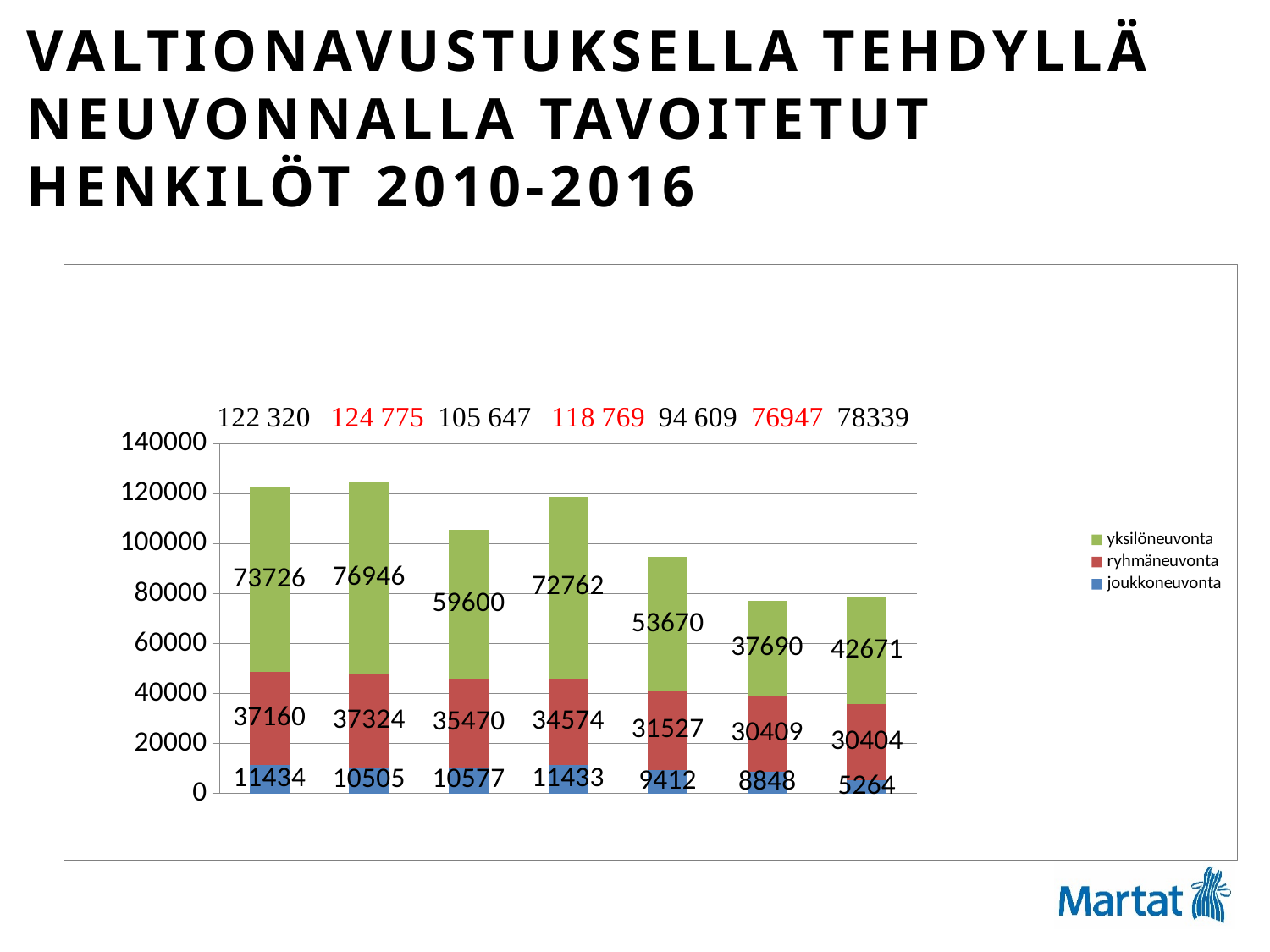
Which colour represents ryhmäneuvonta in the legend? red What is the ryhmäneuvonta value for the fifth bar from the left? 31527 Which is larger, the yksilöneuvonta value of the sixth bar or of the seventh bar from the left? the seventh bar (42671) What is the total printed above the leftmost bar? 122 320 Which bar has the highest yksilöneuvonta value? the second bar from the left What is the yksilöneuvonta value for the leftmost bar? 73726 What kind of chart is shown on the slide? stacked bar chart How many bars are plotted in the chart? 7 Which bar has the lowest joukkoneuvonta value? the rightmost bar What is the joukkoneuvonta value for the rightmost bar? 5264 What is the difference between the yksilöneuvonta values of the fourth and third bars from the left? 13162 How many series does the legend list? 3